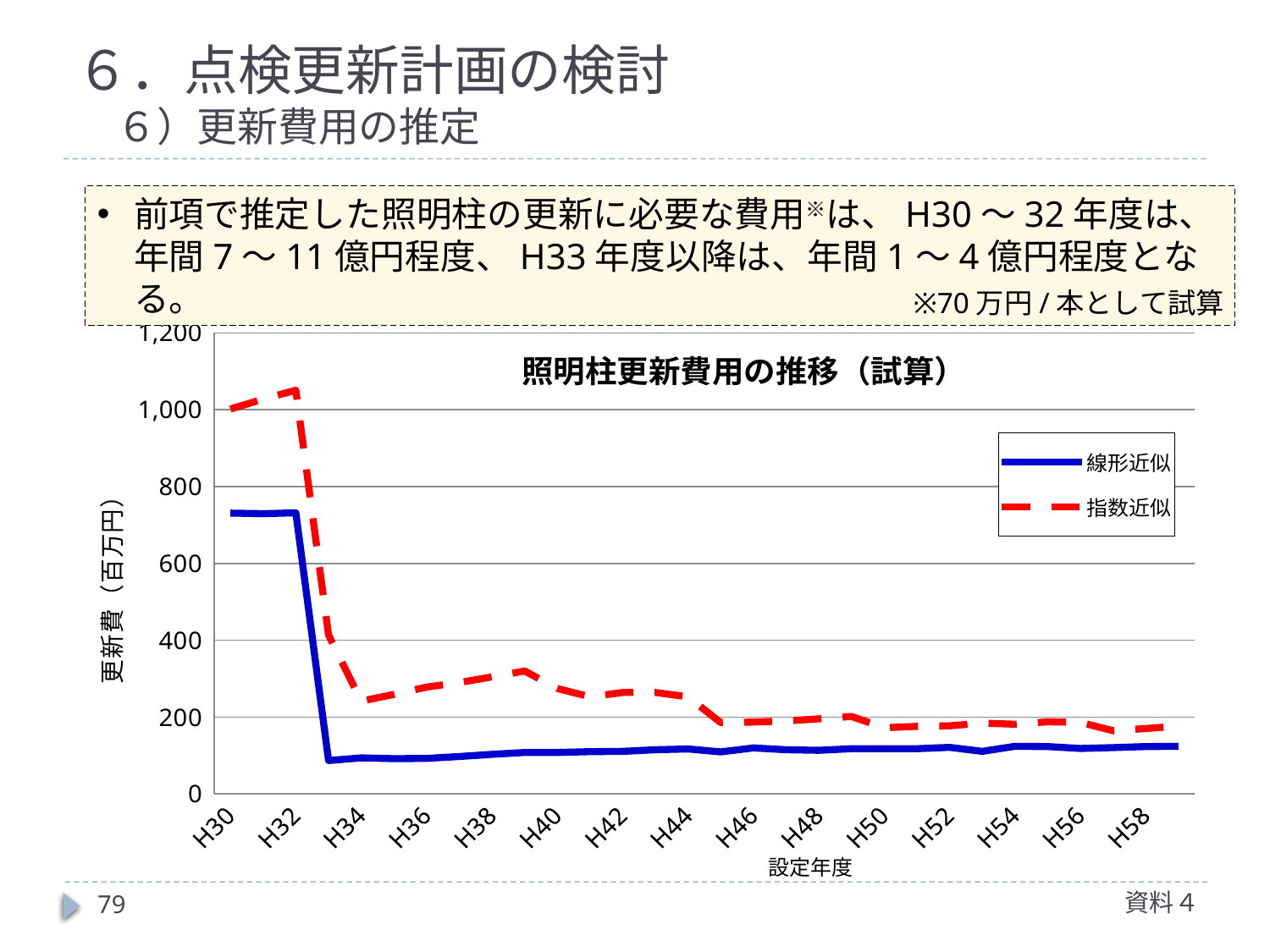
Is the value of 指数近似 at H32 greater or less than 1,000? greater Is the value of 線形近似 at H30 greater or less than 600? greater Is the value of 指数近似 at H38 greater or less than 200? greater At H40, which series has the larger value, 線形近似 or 指数近似? 指数近似 How many series does the legend list? 2 Which series is drawn as a red dashed line? 指数近似 What is the title of the chart? 照明柱更新費用の推移（試算） In which year does 指数近似 reach its highest value? H32 What kind of chart is shown on the slide? line chart Do the values of 線形近似 generally rise or fall from H30 to H58? fall